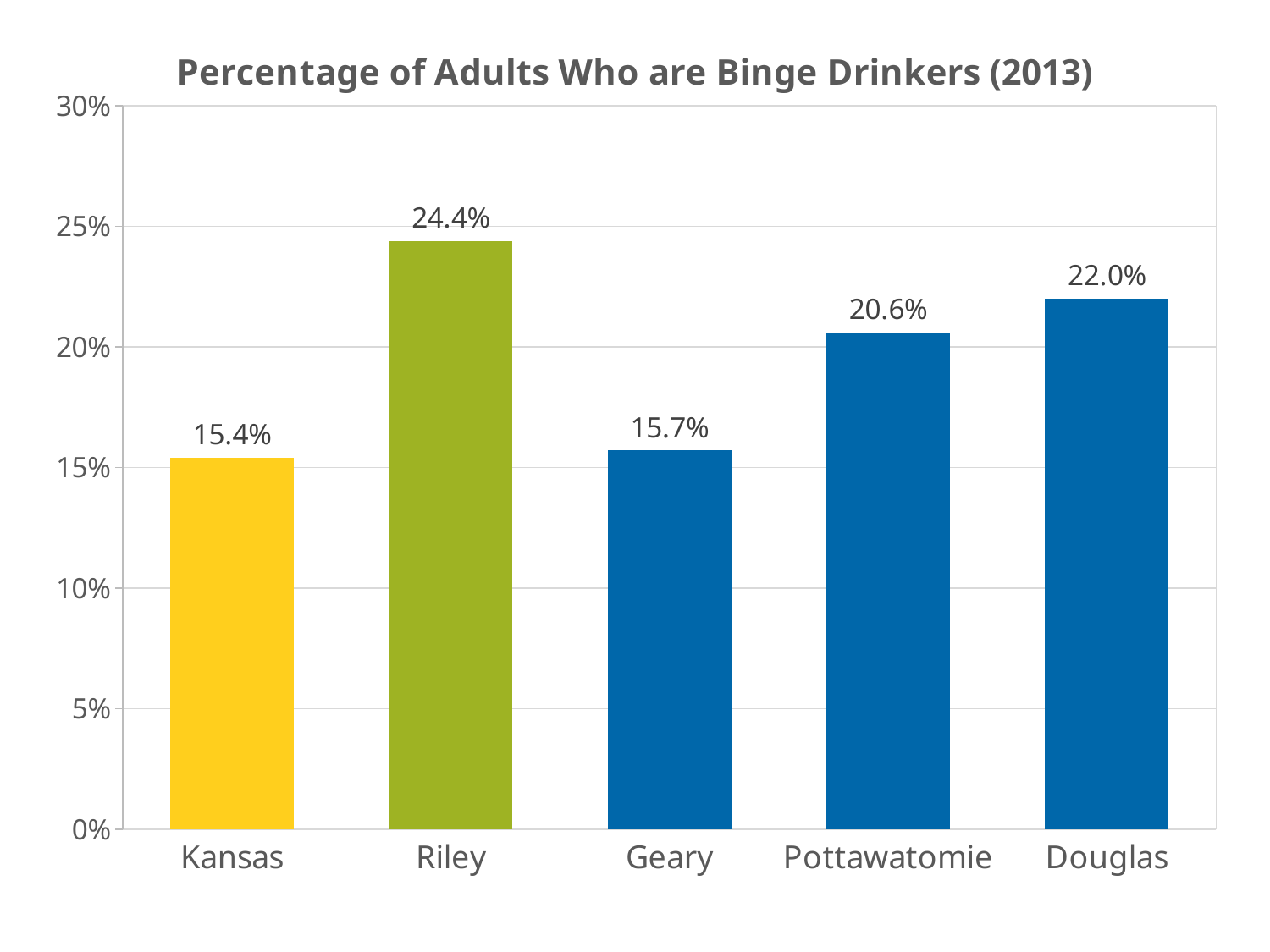
Which has a higher value, Douglas or Pottawatomie? Douglas What is the difference between the values for Riley and Kansas? 9.0% Is the value for Geary greater or less than 20%? less What is the title of the chart? Percentage of Adults Who are Binge Drinkers (2013) Which category has the lowest percentage of binge drinkers? Kansas What kind of chart is shown on the slide? Bar chart What is the difference between the values for Douglas and Geary? 6.3% Which category has the highest percentage of binge drinkers? Riley What is the value shown for Kansas? 15.4% What is the percentage of adults who are binge drinkers in Riley? 24.4% How many categories are shown on the chart? 5 What is the value shown for Pottawatomie? 20.6%